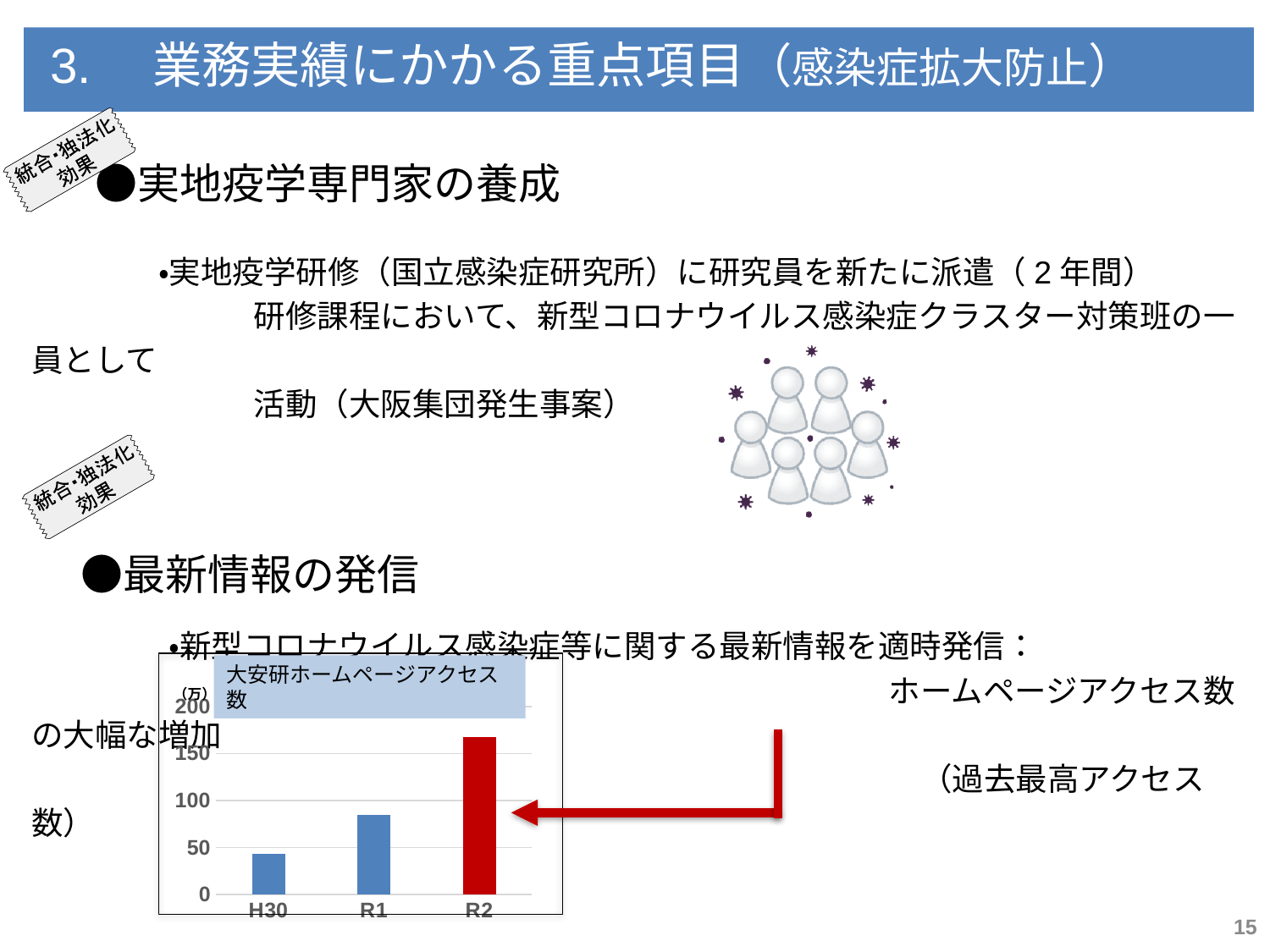
Which category has the lowest value in the chart? H30 Which bar in the chart is coloured red? R2 Which is larger, the value for R1 or the value for H30? R1 Is the value for R2 greater or less than 150? greater Is the value for R1 greater or less than 100? less What is the title of the chart? 大安研ホームページアクセス数 How many categories are plotted on the x axis of the chart? 3 What kind of chart is shown on the slide? bar chart Do the values rise or fall from H30 to R2? rise Which category has the highest value in the chart? R2 Is the value for H30 greater or less than 50? less